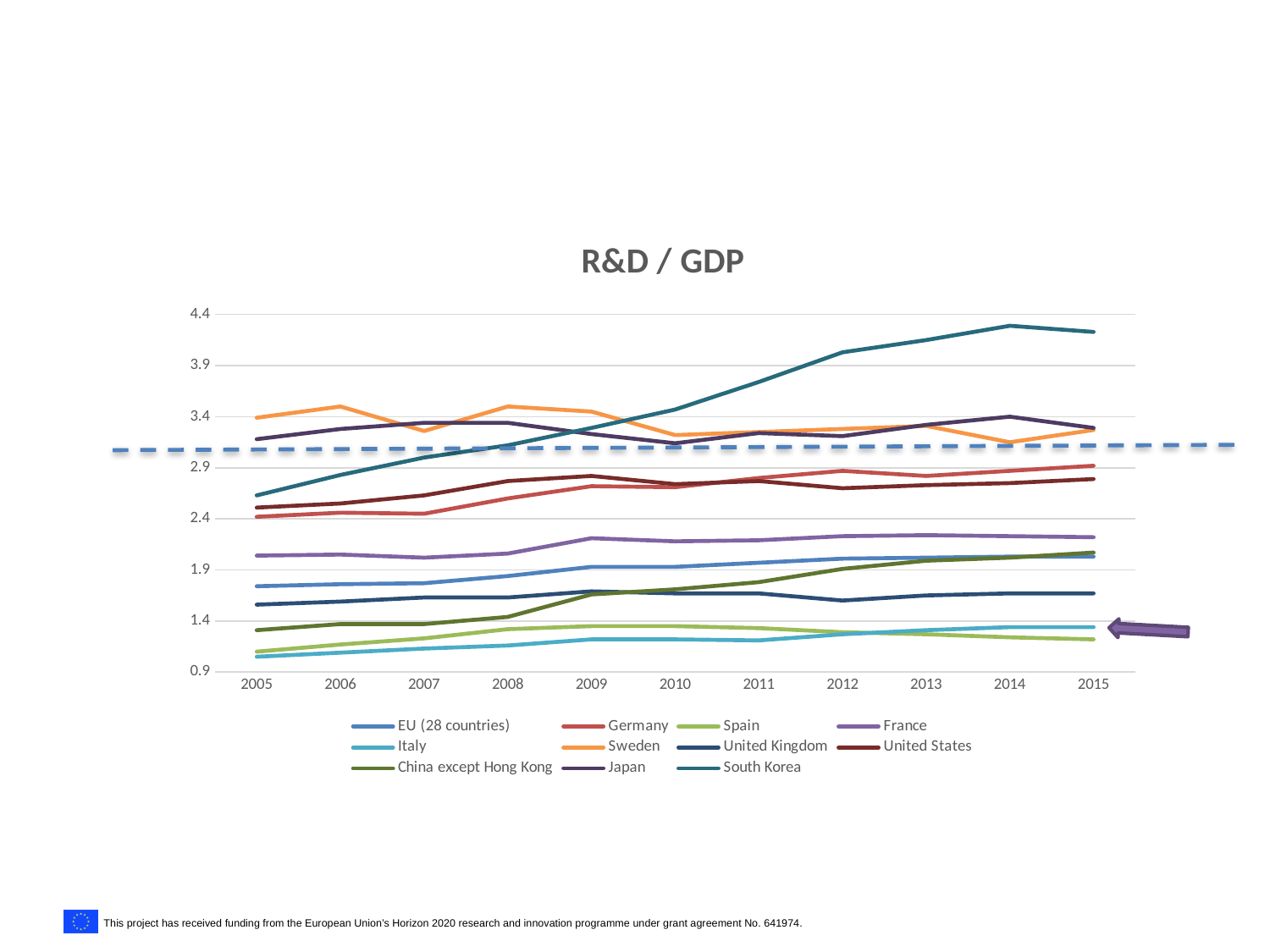
How many years are shown along the x axis? 11 Is the value for South Korea in 2015 greater or less than 3.9? greater What is the title of the chart? R&D / GDP Is the value for Spain in 2005 greater or less than 1.4? less In 2005, which is larger: the value for Sweden or the value for South Korea? Sweden Which country has the lowest R&D / GDP value in 2015? Spain How many series does the legend list? 11 Which country has the highest R&D / GDP value in 2015? South Korea Does the value for South Korea rise or fall from 2005 to 2015? rise What type of chart is shown on the slide? line chart Which country has the highest R&D / GDP value in 2005? Sweden Does the value for China except Hong Kong rise or fall from 2005 to 2015? rise